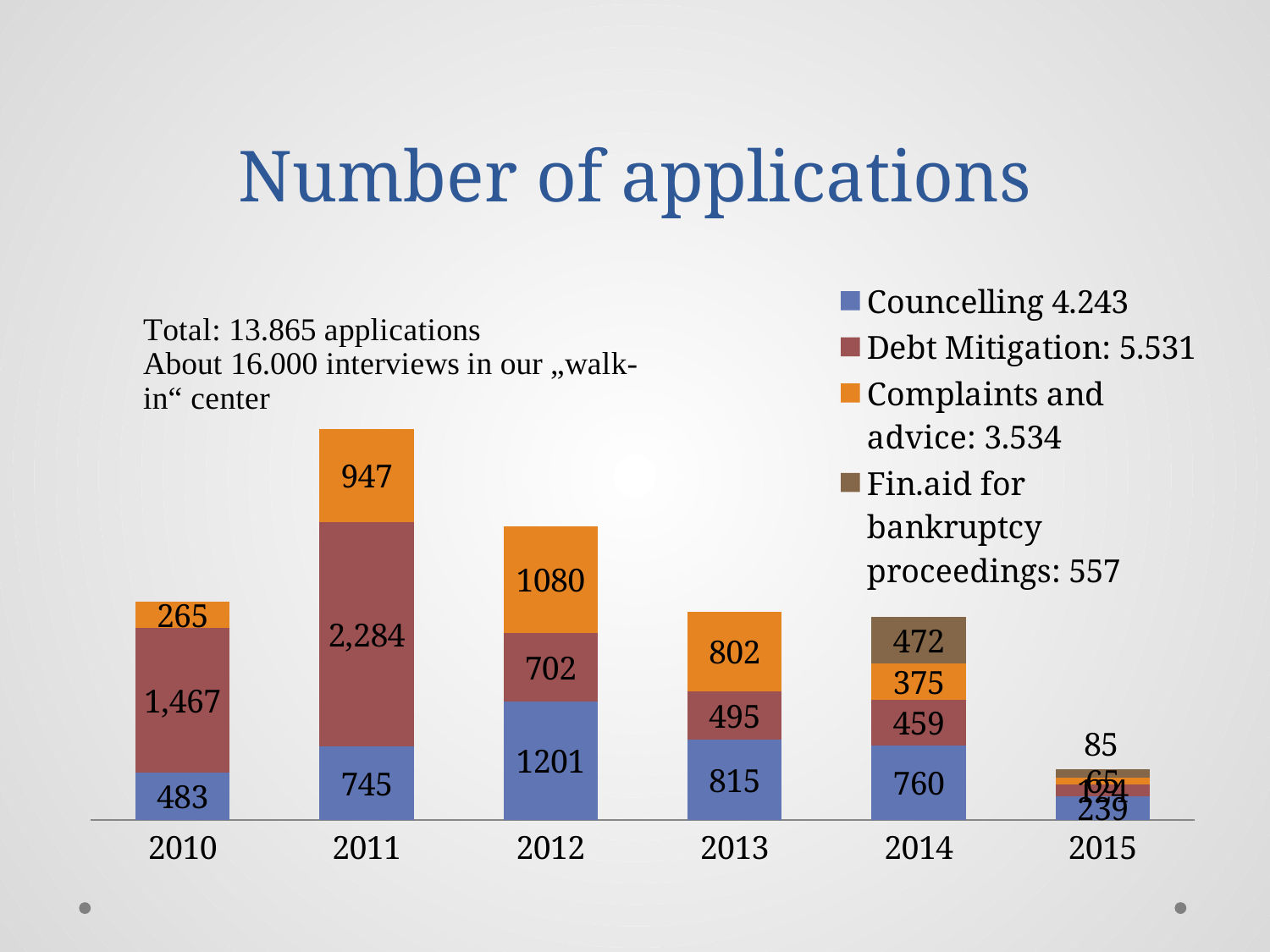
How many series does the legend list? 4 What is the Fin.aid for bankruptcy proceedings value for 2014? 472 How many years are shown on the x axis? 6 Which year has the larger Debt Mitigation value, 2010 or 2012? 2010 What is the Complaints and advice value for 2013? 802 What is the difference between the Councelling values for 2012 and 2010? 718 Which year has the tallest stacked bar? 2011 What is the total of the stacked bar for 2011? 3,976 Which year has the shortest stacked bar? 2015 What is the Councelling value for 2012? 1201 What kind of chart is shown on the slide? Stacked bar chart What is the Debt Mitigation value for 2011? 2,284